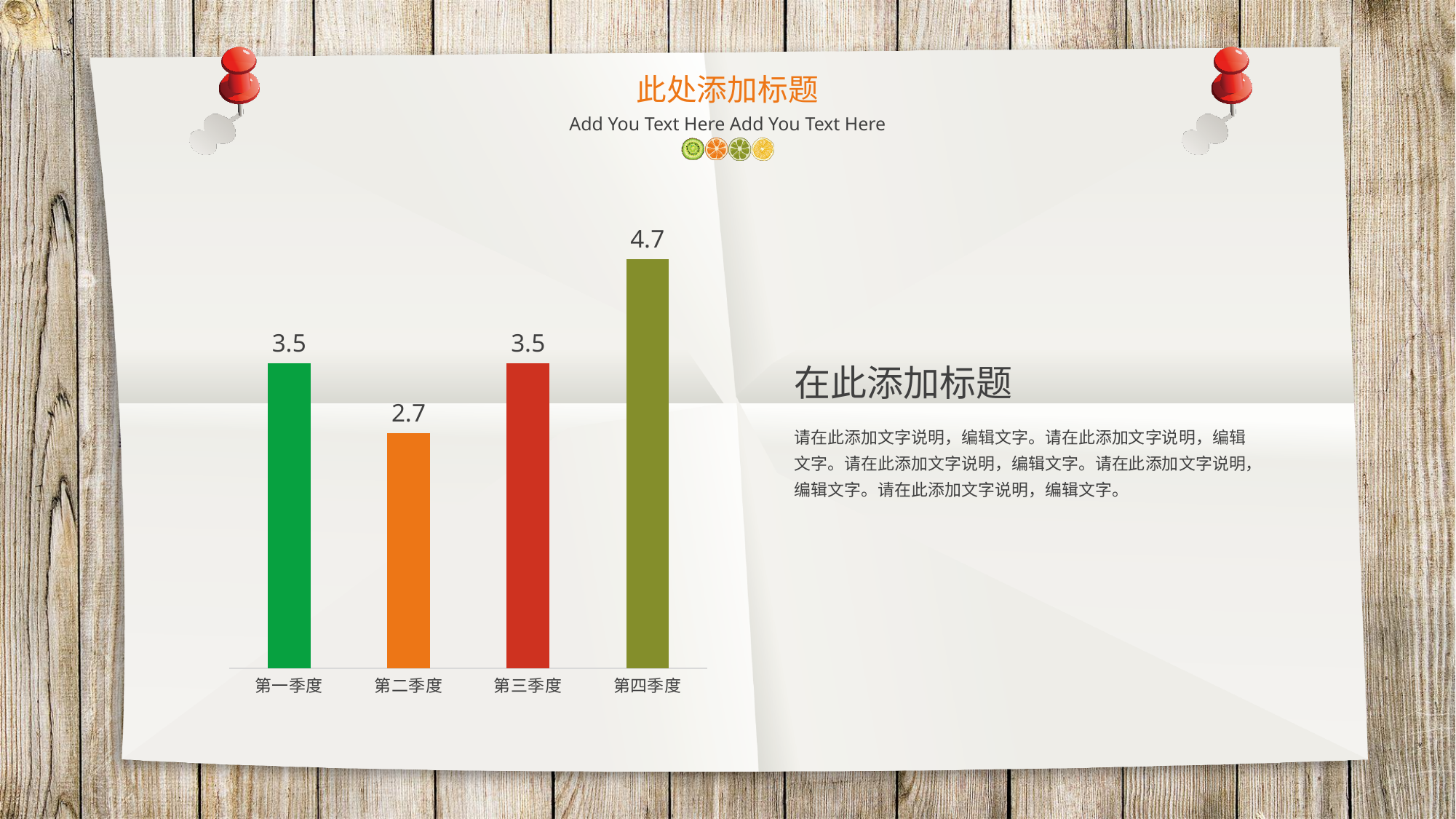
What kind of chart is shown on the slide? Bar chart What is the value for 第一季度? 3.5 Which category has the highest value? 第四季度 What is the value for 第三季度? 3.5 Which category has the lowest value? 第二季度 What is the value for 第二季度? 2.7 What is the value for 第四季度? 4.7 What is the difference between the values for 第四季度 and 第一季度? 1.2 How many categories are shown in the chart? 4 What is the difference between the values for 第四季度 and 第二季度? 2.0 What colour is the bar for 第二季度? Orange Which is larger, the value for 第一季度 or 第二季度? 第一季度